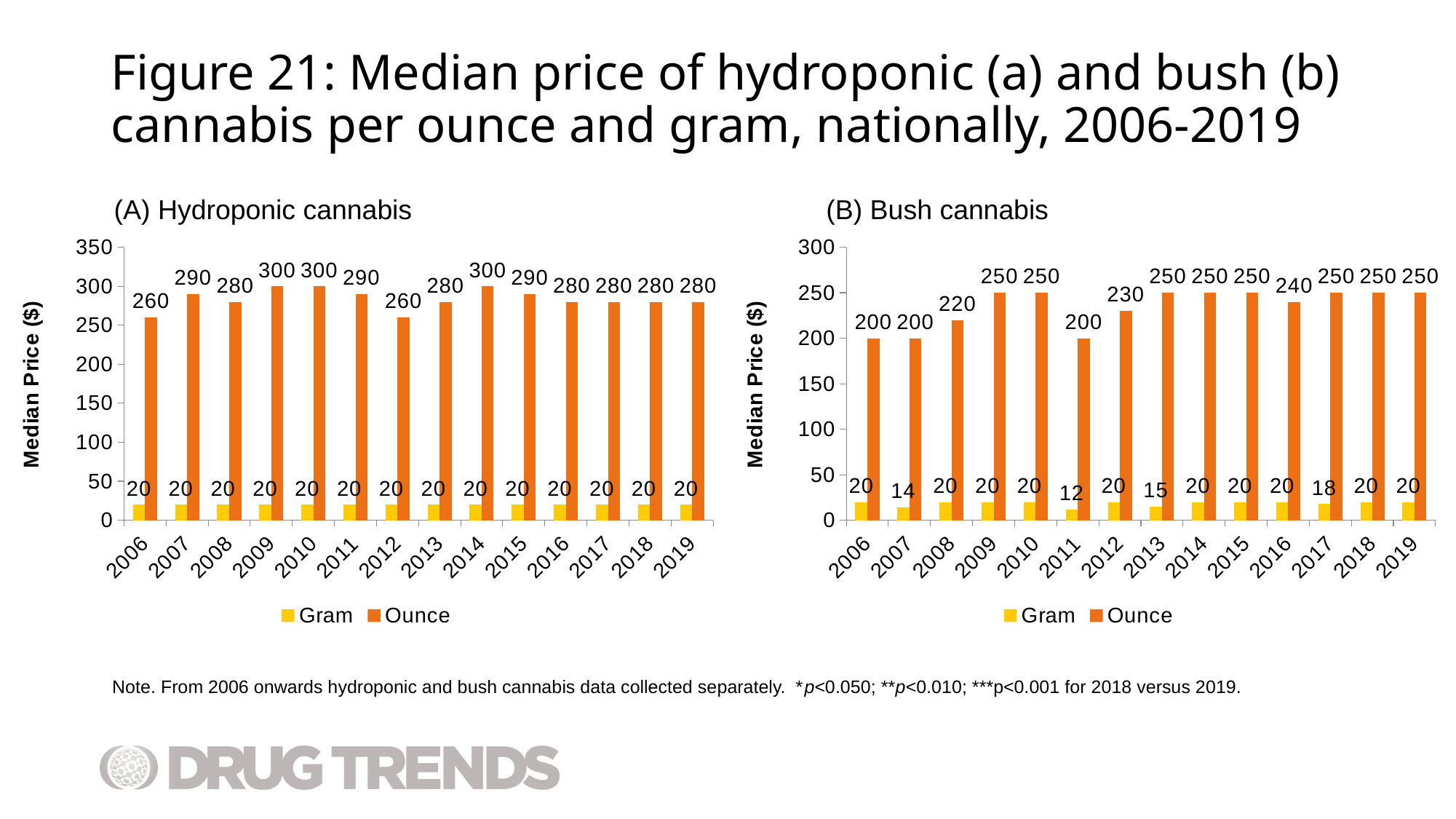
In the (B) Bush cannabis chart, which year has the lowest median price per gram? 2011 In the (B) Bush cannabis chart, what is the difference between the ounce price in 2009 and the ounce price in 2006? 50 What type of chart is the (A) Hydroponic cannabis chart? Bar chart In the (A) Hydroponic cannabis chart, what is the median price per ounce in 2012? 260 How many years are shown on the x axis of the (A) Hydroponic cannabis chart? 14 In the (A) Hydroponic cannabis chart, what is the difference between the ounce price in 2014 and the ounce price in 2012? 40 In the (B) Bush cannabis chart, what is the median price per gram in 2011? 12 In the (A) Hydroponic cannabis chart, is the ounce price higher in 2007 or in 2008? 2007 In the (B) Bush cannabis chart, is the ounce price higher in 2008 or in 2012? 2012 How many series does the legend of the (B) Bush cannabis chart list? 2 What is the y-axis label of the (B) Bush cannabis chart? Median Price ($) In the (B) Bush cannabis chart, what is the median price per ounce in 2016? 240